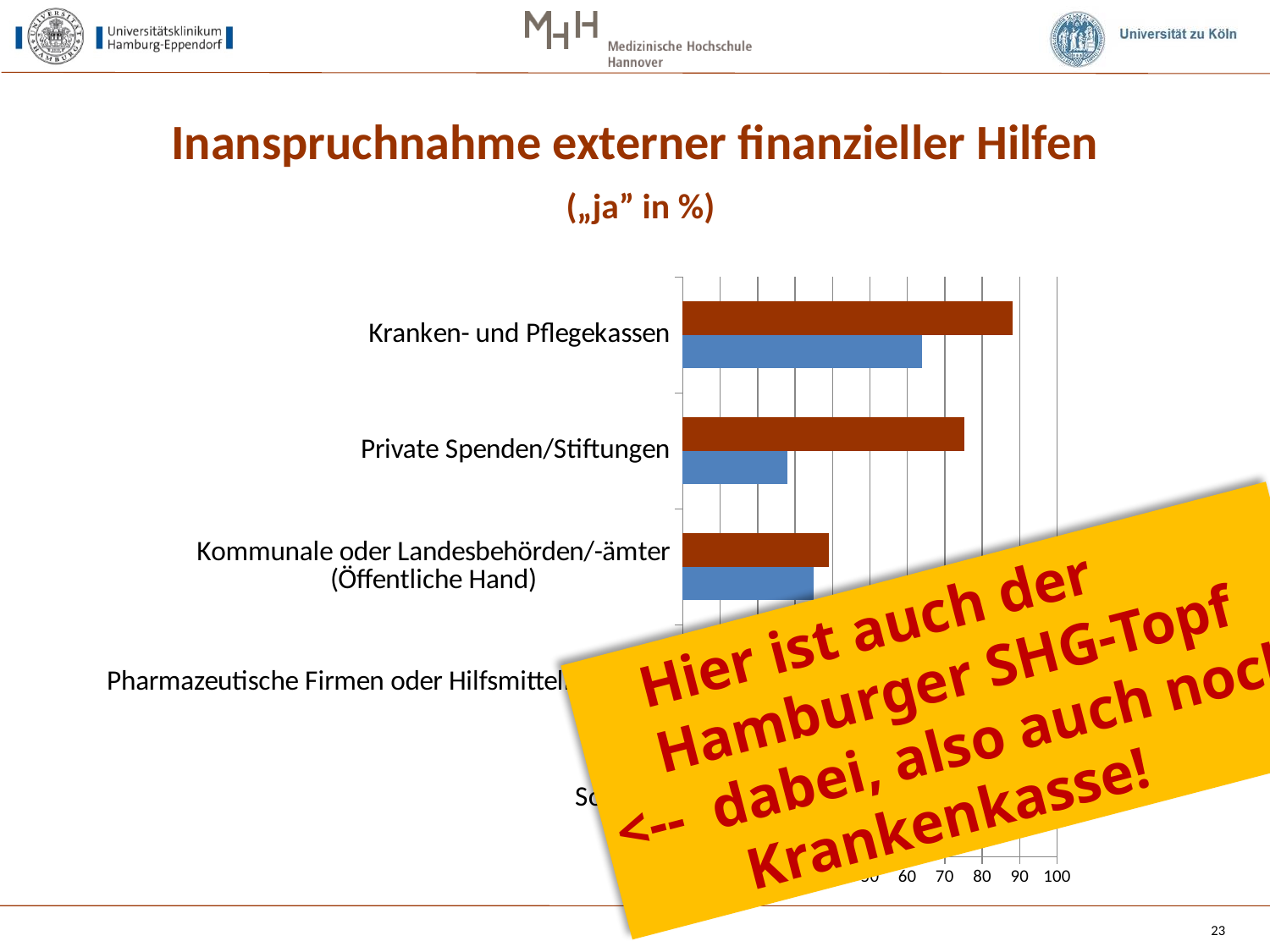
For Private Spenden/Stiftungen, which bar is longer, the brown one or the blue one? the brown one Which category has the longest brown bar? Kranken- und Pflegekassen How many categories are listed on the chart's vertical axis? 5 What kind of chart is shown on the slide? bar chart Is the brown bar for Private Spenden/Stiftungen greater or less than 70? greater Which category has the longest blue bar? Kranken- und Pflegekassen What is the title of the chart on the slide? Inanspruchnahme externer finanzieller Hilfen („ja" in %) Is the blue bar for Kranken- und Pflegekassen greater or less than 60? greater Is the blue bar for Private Spenden/Stiftungen greater or less than 40? less What is the highest value shown on the chart's horizontal axis? 100